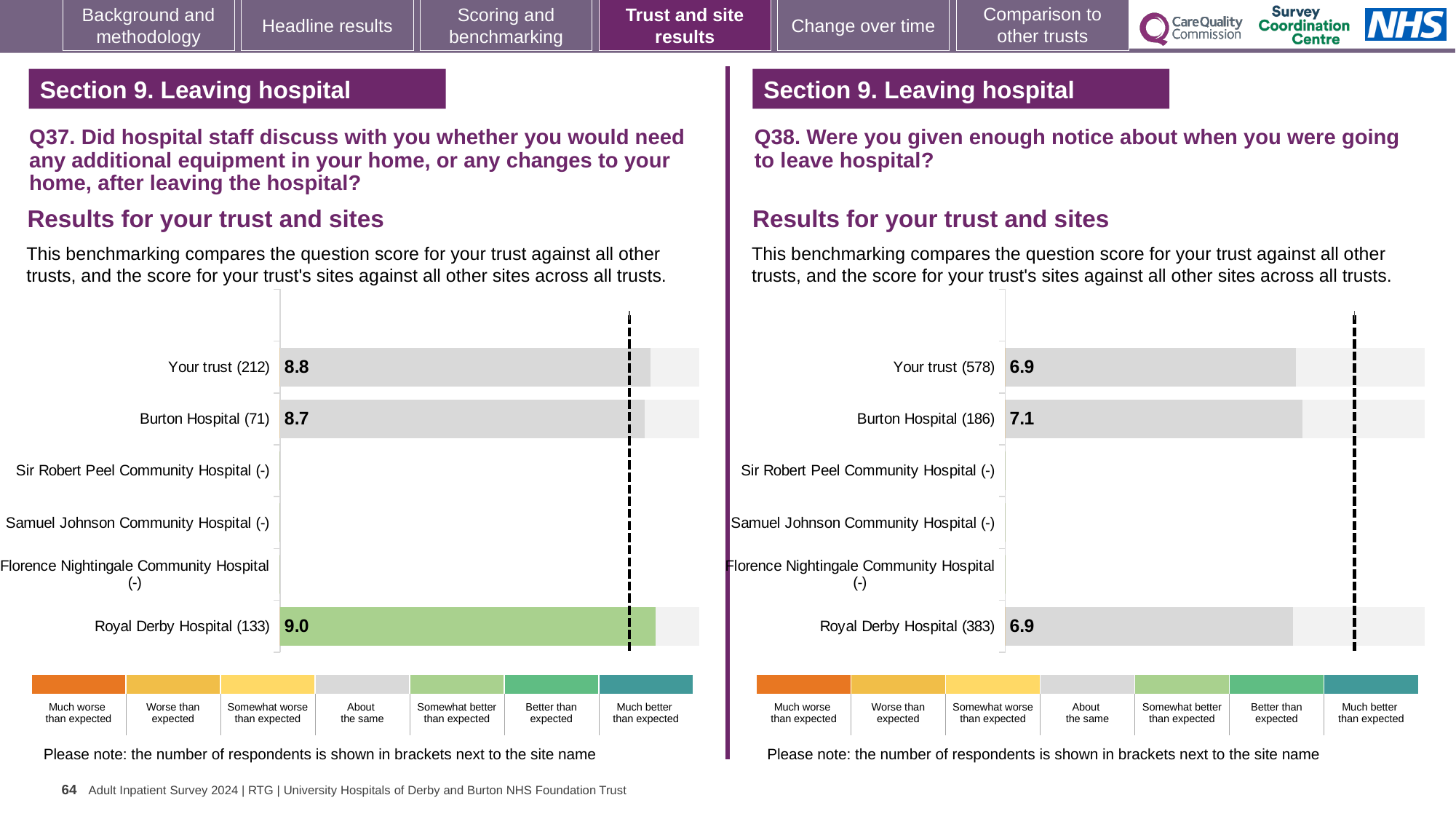
In the Q37 chart on the left, which site's bar is coloured green (somewhat better than expected)? Royal Derby Hospital In the Q37 chart on the left, what is the score for Your trust? 8.8 In the Q37 chart on the left, which is larger: the score for Your trust or the score for Burton Hospital? Your trust In the Q37 chart on the left, what is the difference between the Royal Derby Hospital score and the Burton Hospital score? 0.3 In the Q37 chart on the left, what is the score for Royal Derby Hospital? 9.0 In the Q37 chart on the left, which site has the highest score? Royal Derby Hospital How many respondents are shown in brackets for Royal Derby Hospital in the Q38 chart on the right? 383 In the Q38 chart on the right, what is the difference between the Burton Hospital score and the Your trust score? 0.2 In the Q38 chart on the right, which site has the highest score? Burton Hospital In the Q38 chart on the right, what is the score for Your trust? 6.9 In the Q38 chart on the right, what is the score for Burton Hospital? 7.1 What type of chart is used on the left for Q37? Bar chart